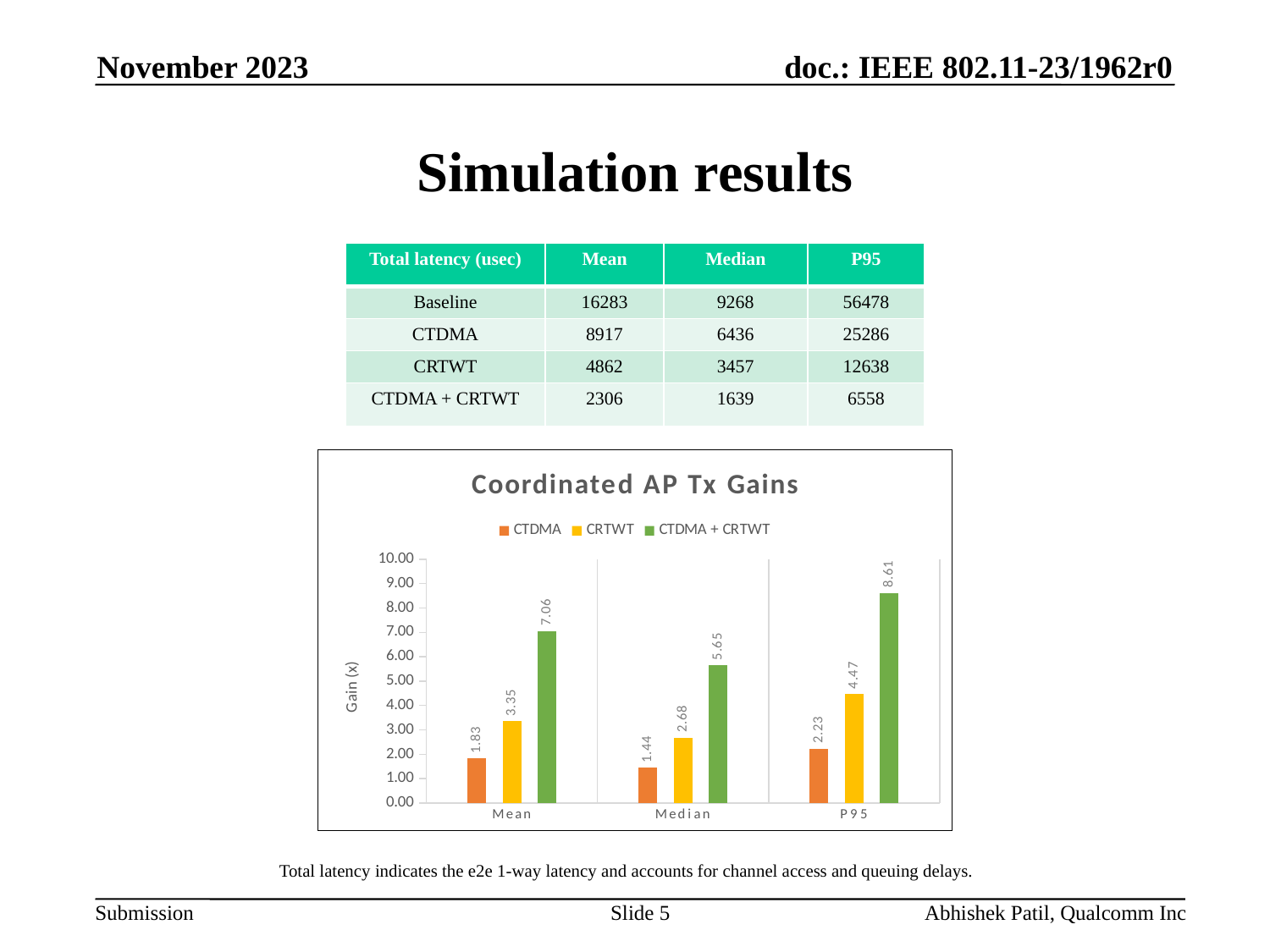
In the Coordinated AP Tx Gains chart, which is larger for P95: the CRTWT gain or the CTDMA gain? CRTWT How many categories are shown on the x axis of the Coordinated AP Tx Gains chart? 3 How many series does the legend of the Coordinated AP Tx Gains chart list? 3 Is the CTDMA + CRTWT gain for Median greater or less than 5.00 in the Coordinated AP Tx Gains chart? greater Which category has the lowest CTDMA gain in the Coordinated AP Tx Gains chart? Median What is the CTDMA + CRTWT gain for P95 in the Coordinated AP Tx Gains chart? 8.61 What kind of chart is the Coordinated AP Tx Gains chart? bar chart What is the difference between the CTDMA + CRTWT gain and the CTDMA gain for Mean in the Coordinated AP Tx Gains chart? 5.23 What is the y-axis label of the Coordinated AP Tx Gains chart? Gain (x) Which category has the highest CTDMA + CRTWT gain in the Coordinated AP Tx Gains chart? P95 What is the CTDMA gain for Median in the Coordinated AP Tx Gains chart? 1.44 What is the CRTWT gain for Mean in the Coordinated AP Tx Gains chart? 3.35